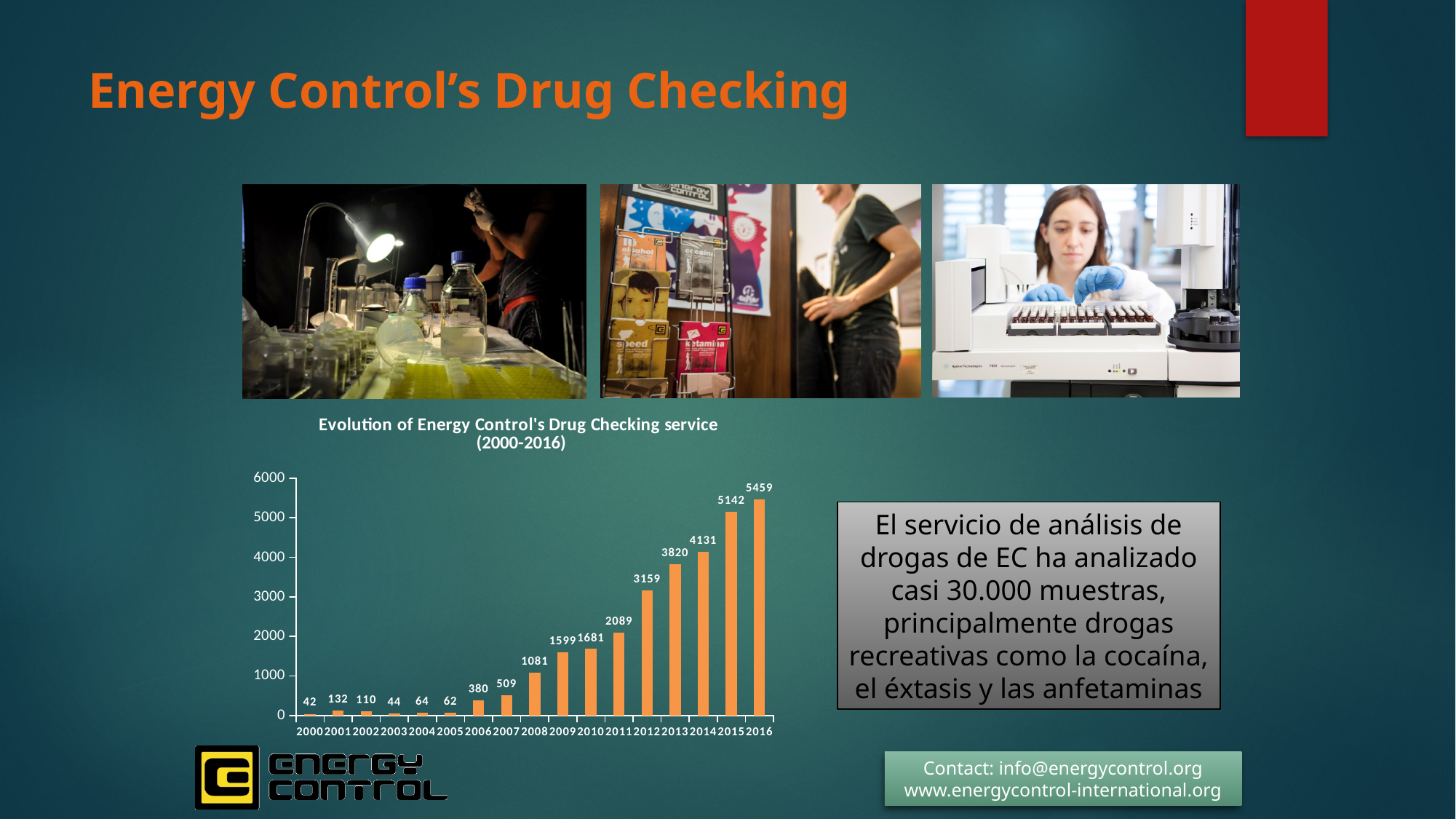
What is the difference between the values for 2013 and 2012? 661 What is the value for 2008? 1081 Which year has the highest value? 2016 What kind of chart is shown on the slide? bar chart What is the title of the chart? Evolution of Energy Control's Drug Checking service (2000-2016) How many years are shown on the x axis? 17 What is the value for 2001? 132 What is the difference between the values for 2016 and 2015? 317 What is the value for 2016? 5459 Which year has the lowest value? 2000 Is the value for 2014 greater or less than 4000? greater Which is larger, the value for 2002 or the value for 2003? 2002